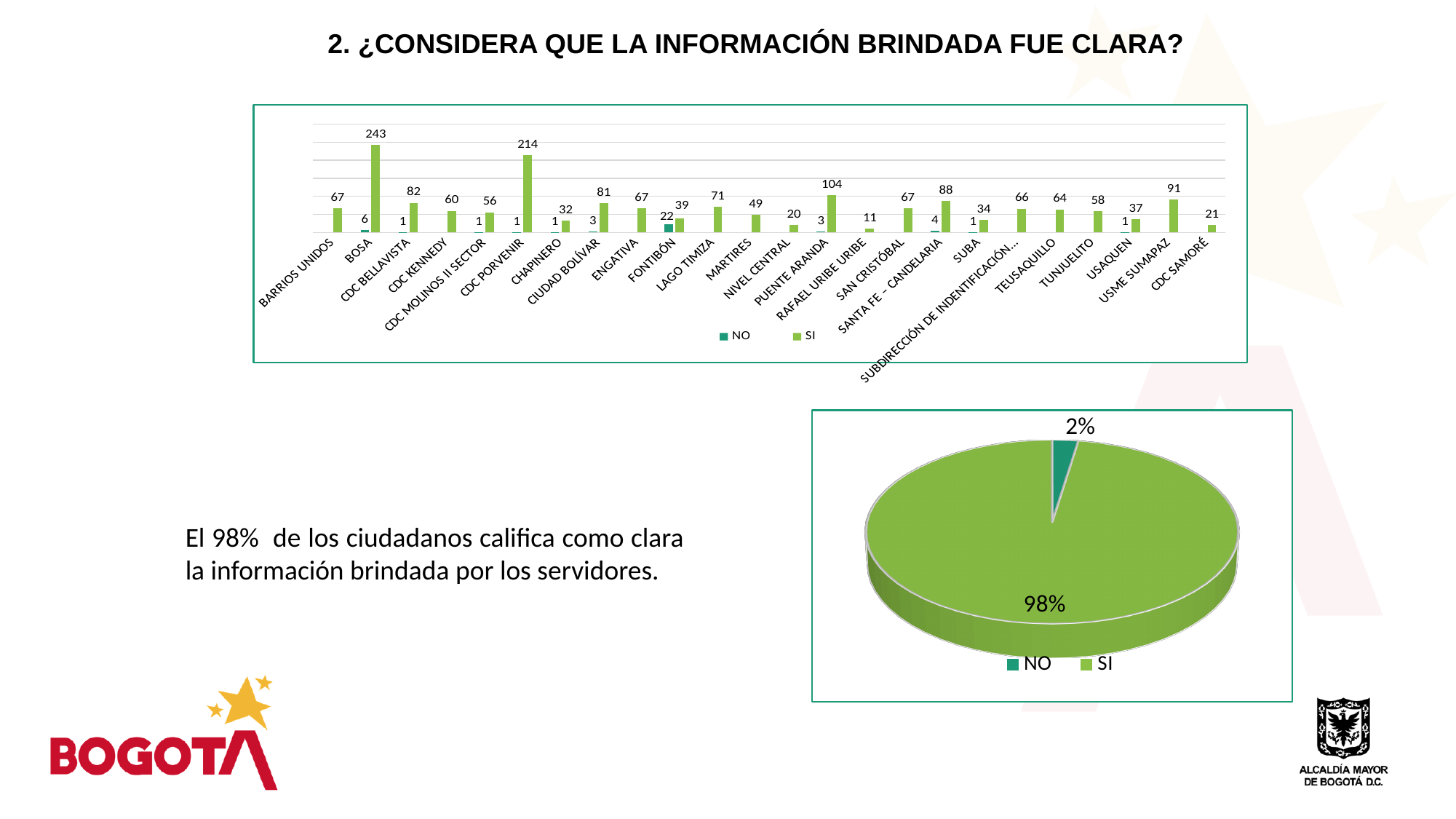
How many series does the legend of the bar chart list? 2 In the bar chart, which has a larger SI value, PUENTE ARANDA or USME SUMAPAZ? PUENTE ARANDA In the bar chart, what is the SI value for BOSA? 243 In the bar chart, which category has the highest NO value? FONTIBÓN In the bar chart, what is the SI value for CDC PORVENIR? 214 What kind of chart is the chart at the bottom right of the slide? Pie chart In the bar chart, what is the NO value for FONTIBÓN? 22 In the bar chart, what is the difference between the SI values for BOSA and CDC PORVENIR? 29 In the pie chart, what share of the pie is the NO slice? 2% How many categories are shown on the x axis of the bar chart? 24 In the bar chart, which category has the highest SI value? BOSA In the bar chart, what is the SI value for RAFAEL URIBE URIBE? 11